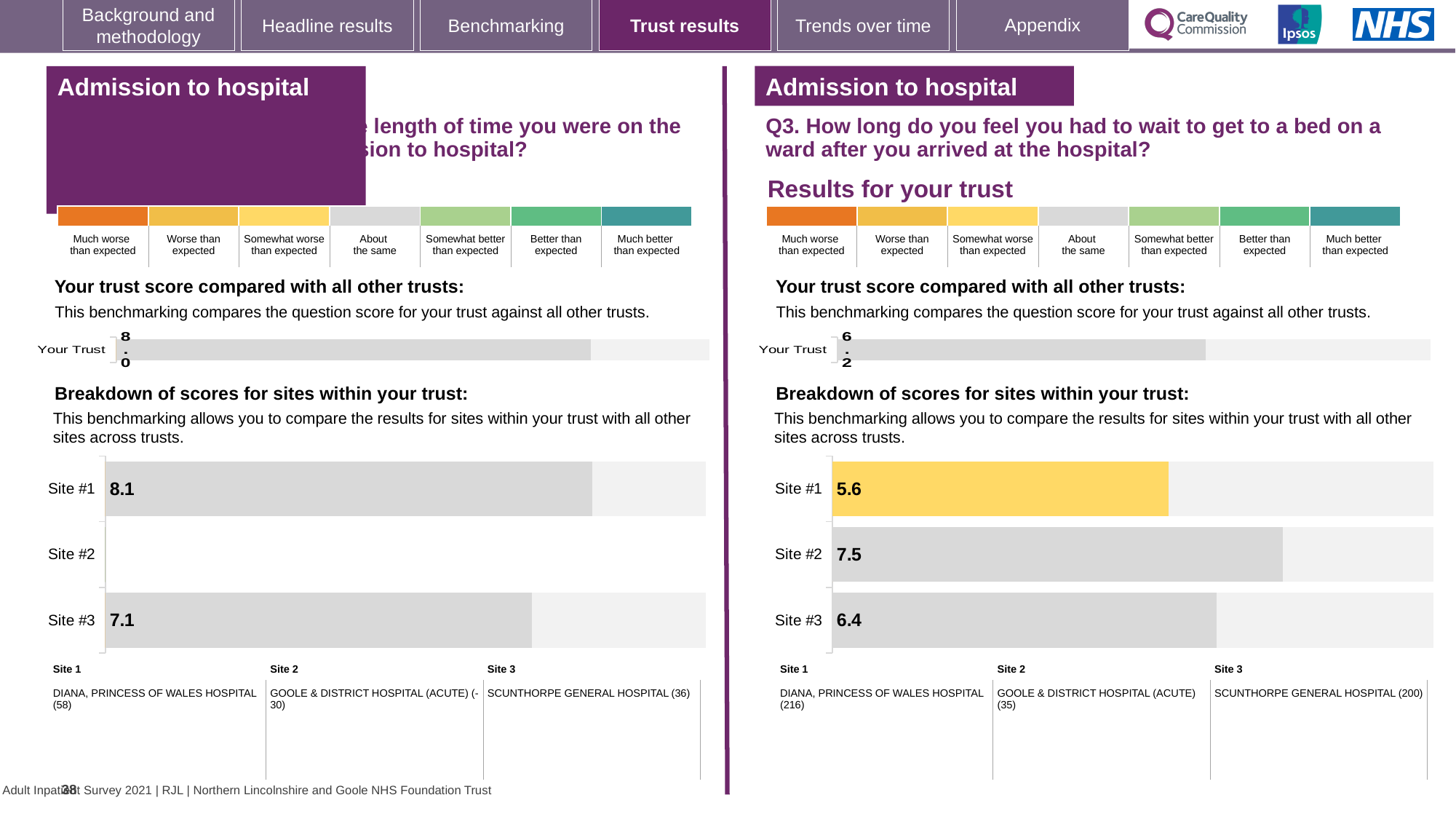
On the left-hand site breakdown chart, what is the score for Site #1? 8.1 On the right-hand 'Your trust score compared with all other trusts' chart (Q3), what is the score for Your Trust? 6.2 On the left-hand 'Your trust score compared with all other trusts' chart, what is the score for Your Trust? 8.0 On the right-hand chart (Q3), what is the score for Site #2? 7.5 On the right-hand chart (Q3), what is the difference between the scores for Site #2 and Site #1? 1.9 On the right-hand chart (Q3), what is the score for Site #3? 6.4 On the right-hand chart (Q3), which site has the highest score? Site #2 On the right-hand chart (Q3), which site has the lowest score? Site #1 On the left-hand site breakdown chart, which of Site #1 or Site #3 has the higher score? Site #1 On the left-hand site breakdown chart, what is the score for Site #3? 7.1 On the right-hand chart (Q3, wait to get to a bed on a ward), what is the score for Site #1? 5.6 What type of chart is used for the site breakdown on the right-hand side of the slide? Bar chart